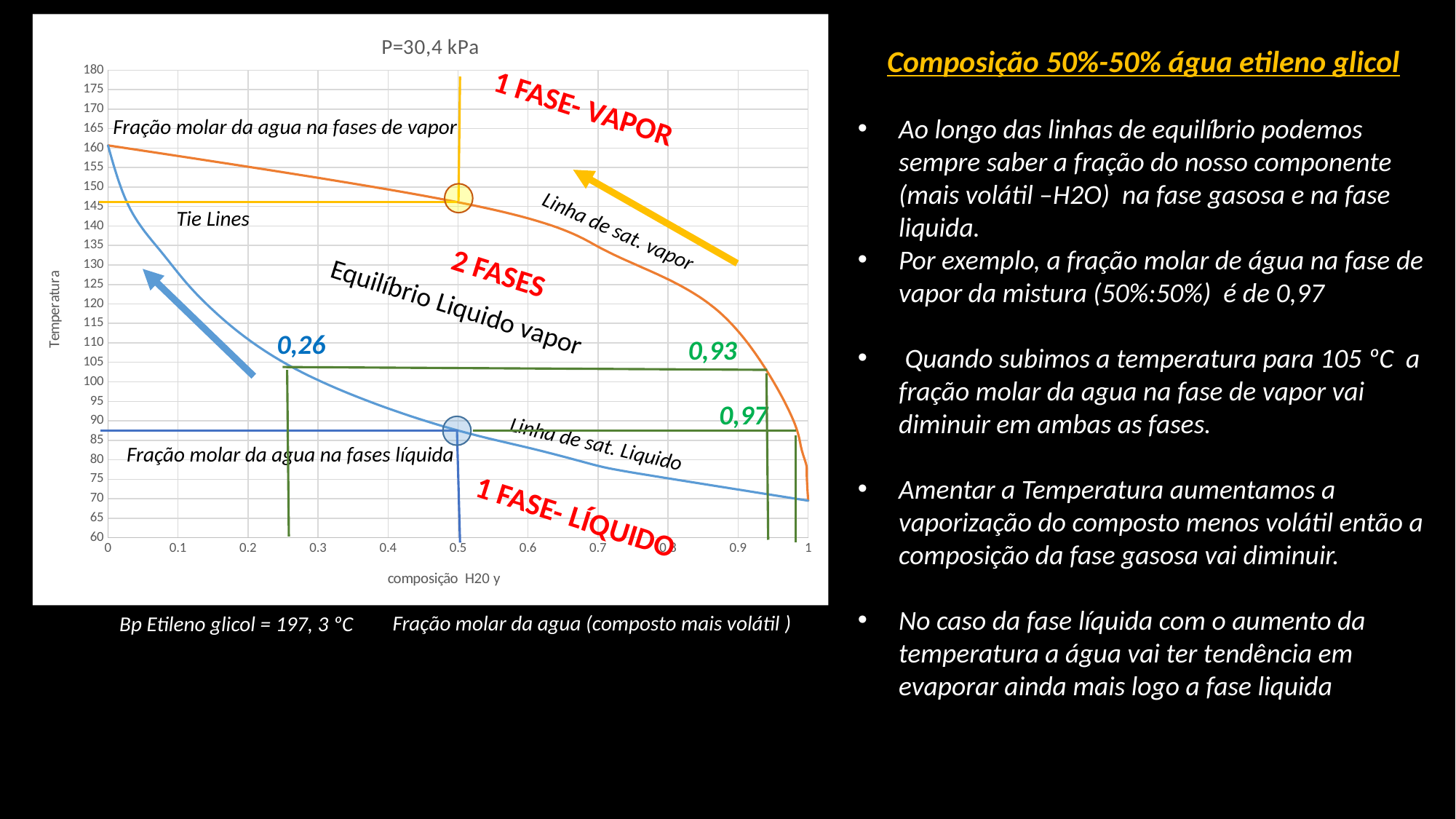
According to the annotation on the chart, what is the mole fraction of water in the vapor phase on the tie line at about 105 °C? 0,93 What is the label of the x axis of the chart? composição H20 y What kind of chart is shown on the slide? line chart Do the curves rise or fall as the composition of H2O increases along the x axis? fall According to the annotation on the chart, what is the mole fraction of water in the vapor phase for the 50%:50% mixture at the lower tie line? 0,97 How many curves (saturation lines) are plotted on the chart? 2 At a composition of 0.5, is the temperature on the 'Linha de sat. Liquido' greater or less than 100? less According to the annotation on the chart, what is the mole fraction of water in the liquid phase on the tie line at about 105 °C? 0,26 At a composition of 0.5, which curve is at a higher temperature, 'Linha de sat. vapor' or 'Linha de sat. Liquido'? Linha de sat. vapor What is the highest value shown on the Temperatura axis of the chart? 180 At a composition of 0.5, is the temperature on the 'Linha de sat. vapor' greater or less than 140? greater What is the title of the chart? P=30,4 kPa